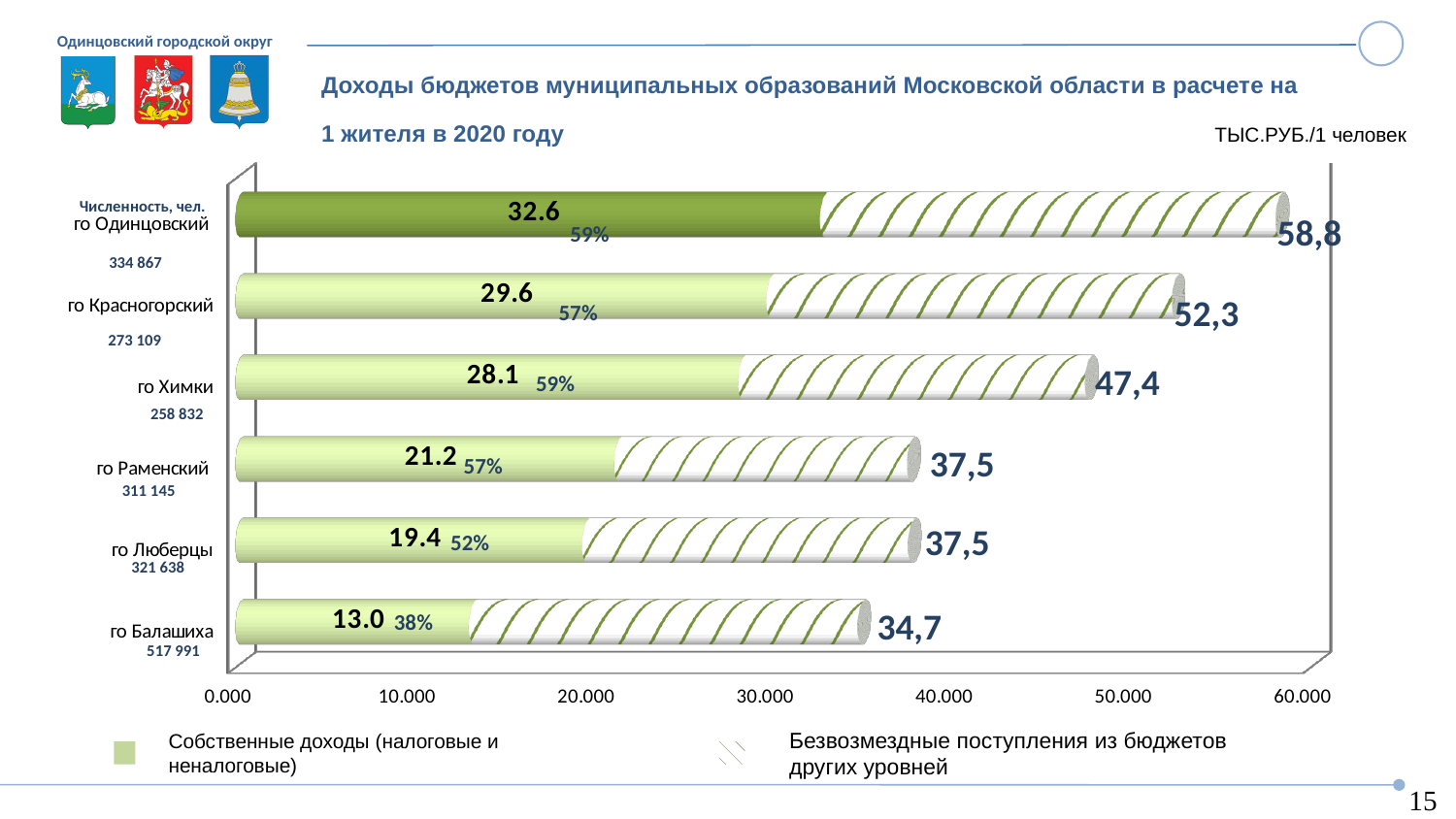
How many municipalities are shown in the chart? 6 Is the total value for го Балашиха greater or less than 30.000? greater What population (Численность, чел.) is shown for го Одинцовский? 334 867 Which municipality has the highest total income per resident? го Одинцовский What is the value of own revenues (Собственные доходы) for го Химки? 28.1 Which has larger own revenues: го Химки or го Раменский? го Химки What kind of chart is shown on the slide? bar chart What is the difference between the own revenues of го Одинцовский (32.6) and го Красногорский (29.6)? 3.0 How many series does the legend list? 2 What is the total budget income per resident shown for го Красногорский? 52,3 Which municipality has the lowest own revenues (Собственные доходы) value? го Балашиха What percentage share of own revenues is shown for го Люберцы? 52%